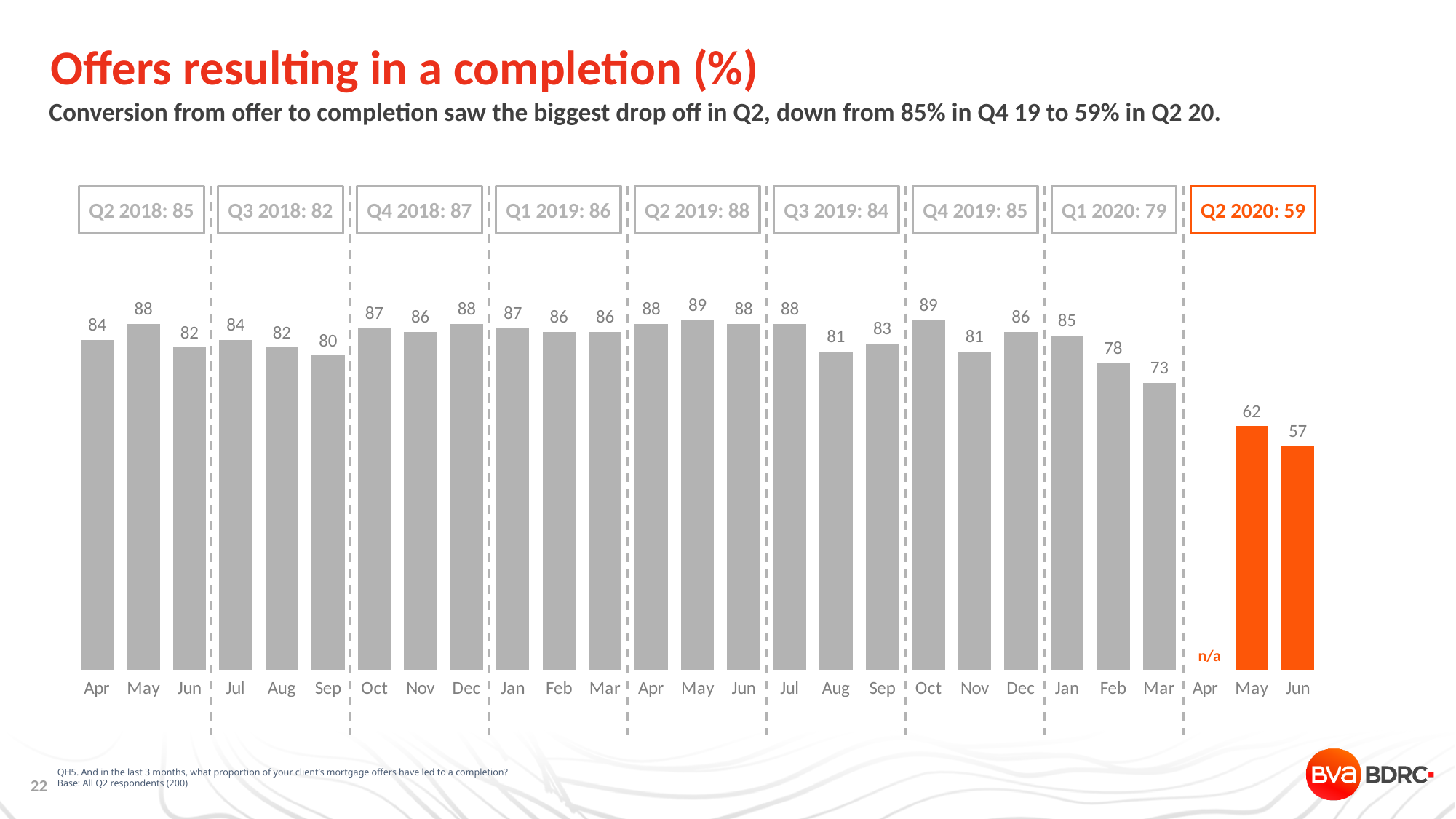
What is the quarterly figure shown in the box for Q2 2019? 88 What is the value for Mar in Q1 2020? 73 Which is larger, the value for Feb in Q1 2020 or the value for Feb in Q1 2019? Feb in Q1 2019 How many quarterly summary boxes are shown above the chart? 9 What is the difference between the quarterly figures for Q4 2019 and Q2 2020? 26 What is the difference between the values for May and Jun in Q2 2020? 5 What is shown for Apr in Q2 2020 instead of a bar? n/a What type of chart is shown on the slide? bar chart What is the value for Jun in Q2 2020? 57 What is the highest monthly value shown on the chart? 89 What is the value for Sep in Q3 2018? 80 Which month has the lowest value on the chart? Jun (Q2 2020)